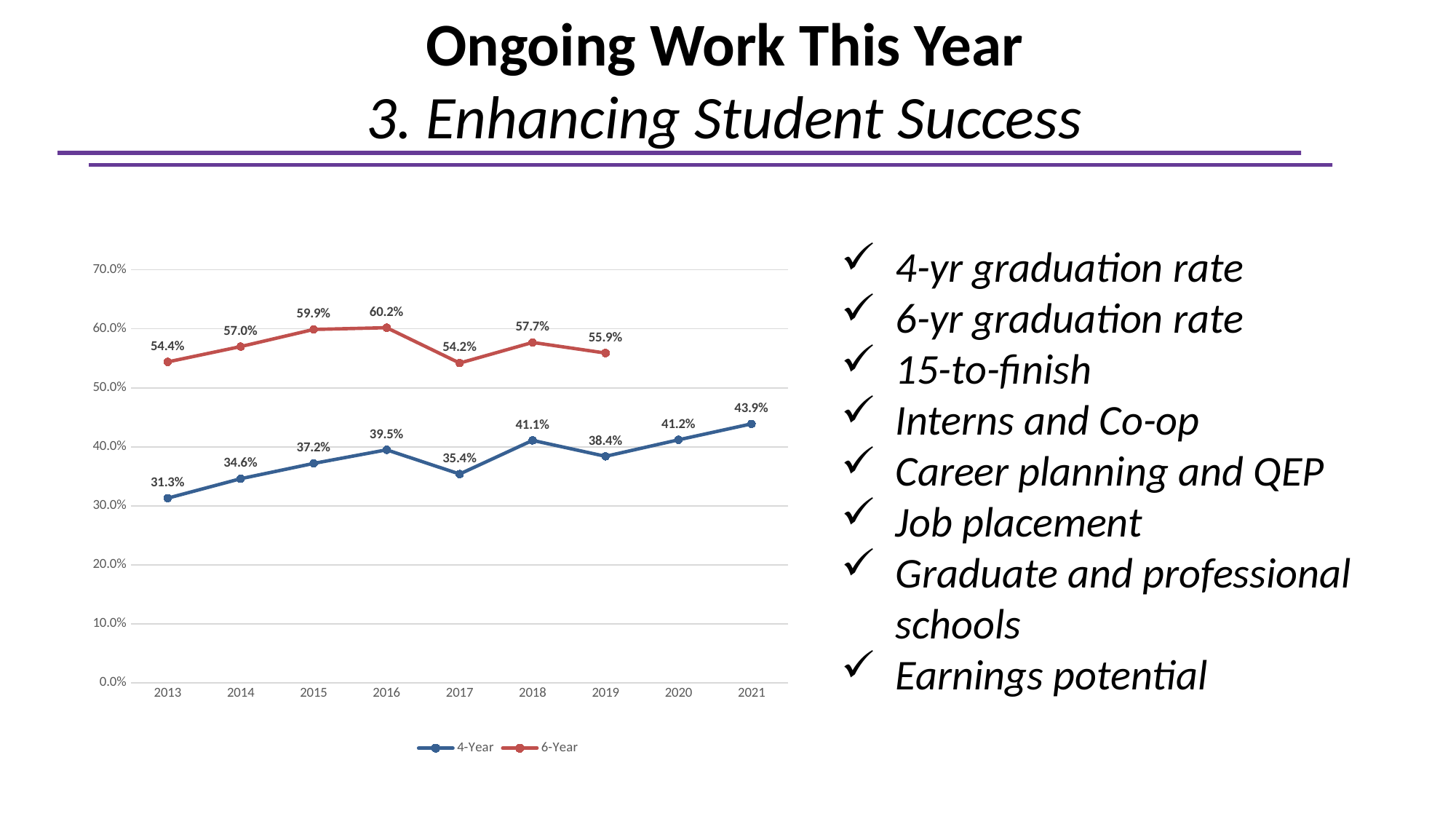
What is the 4-Year value for 2021? 43.9% In which year is the 4-Year series lowest? 2013 What is the 4-Year value for 2013? 31.3% What kind of chart is shown on the slide? Line chart What is the 6-Year value for 2016? 60.2% What is the difference between the 6-Year and 4-Year values in 2017? 18.8% In which year is the 6-Year series highest? 2016 What colour is the 6-Year line? Red How many series does the legend list? 2 Which is larger, the 4-Year value for 2018 or the 4-Year value for 2019? 2018 How many years are shown on the x axis? 9 What is the 6-Year value for 2019? 55.9%